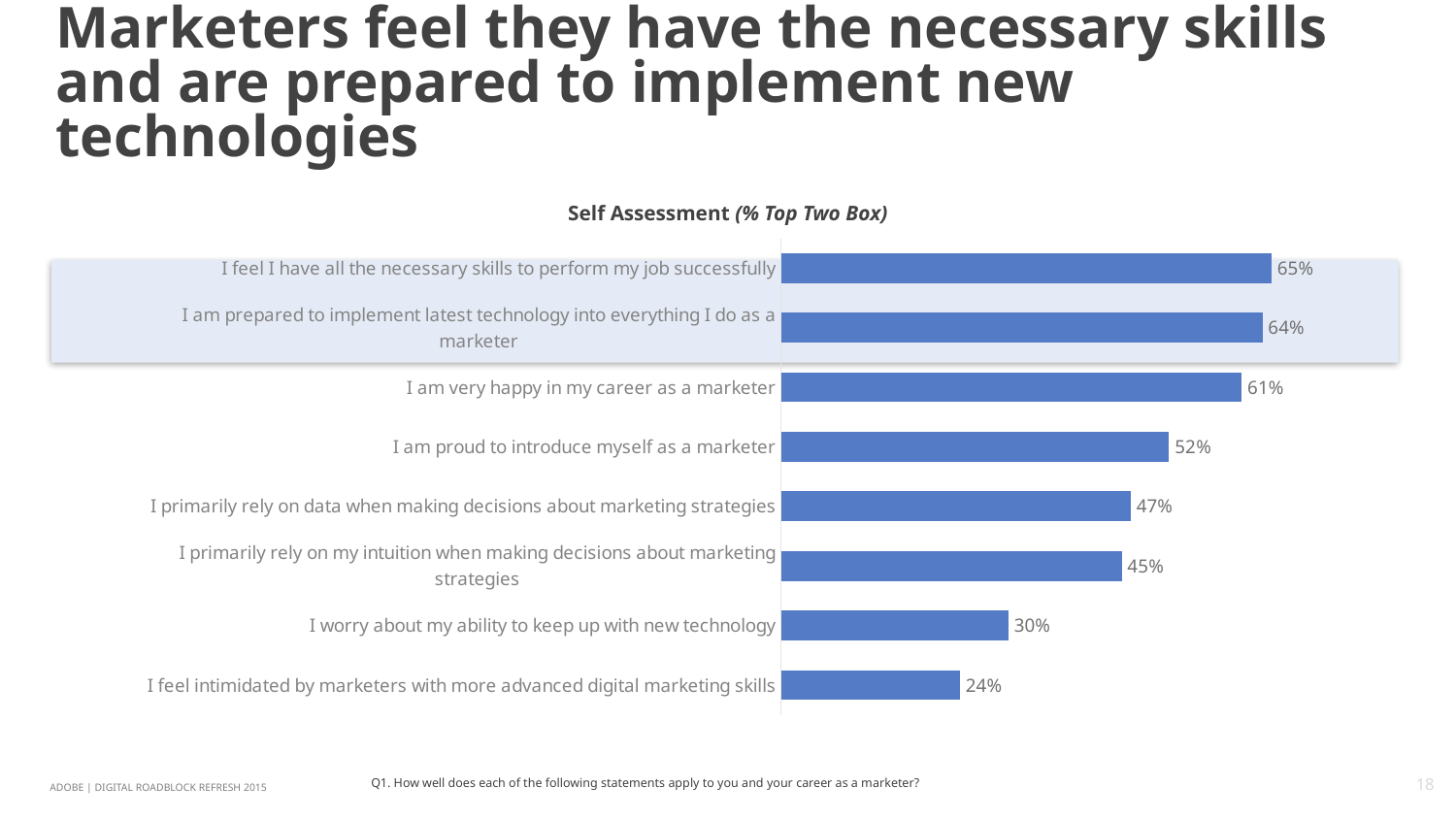
What percentage of marketers say they primarily rely on data when making decisions about marketing strategies? 47% What is the title of the chart? Self Assessment (% Top Two Box) What kind of chart is shown on the slide? Bar chart How many statements have a value of 60% or higher? 3 What is the difference between the value for "I am very happy in my career as a marketer" and the value for "I am proud to introduce myself as a marketer"? 9% How many statements are shown in the chart? 8 Which statement has the highest value in the chart? I feel I have all the necessary skills to perform my job successfully Which statement has the lowest value in the chart? I feel intimidated by marketers with more advanced digital marketing skills What is the value for "I worry about my ability to keep up with new technology"? 30% What is the difference between the value for "I worry about my ability to keep up with new technology" and the value for "I feel intimidated by marketers with more advanced digital marketing skills"? 6% What percentage of marketers say they feel they have all the necessary skills to perform their job successfully? 65% Which is larger: the value for relying on data or the value for relying on intuition when making marketing decisions? Relying on data (47%)